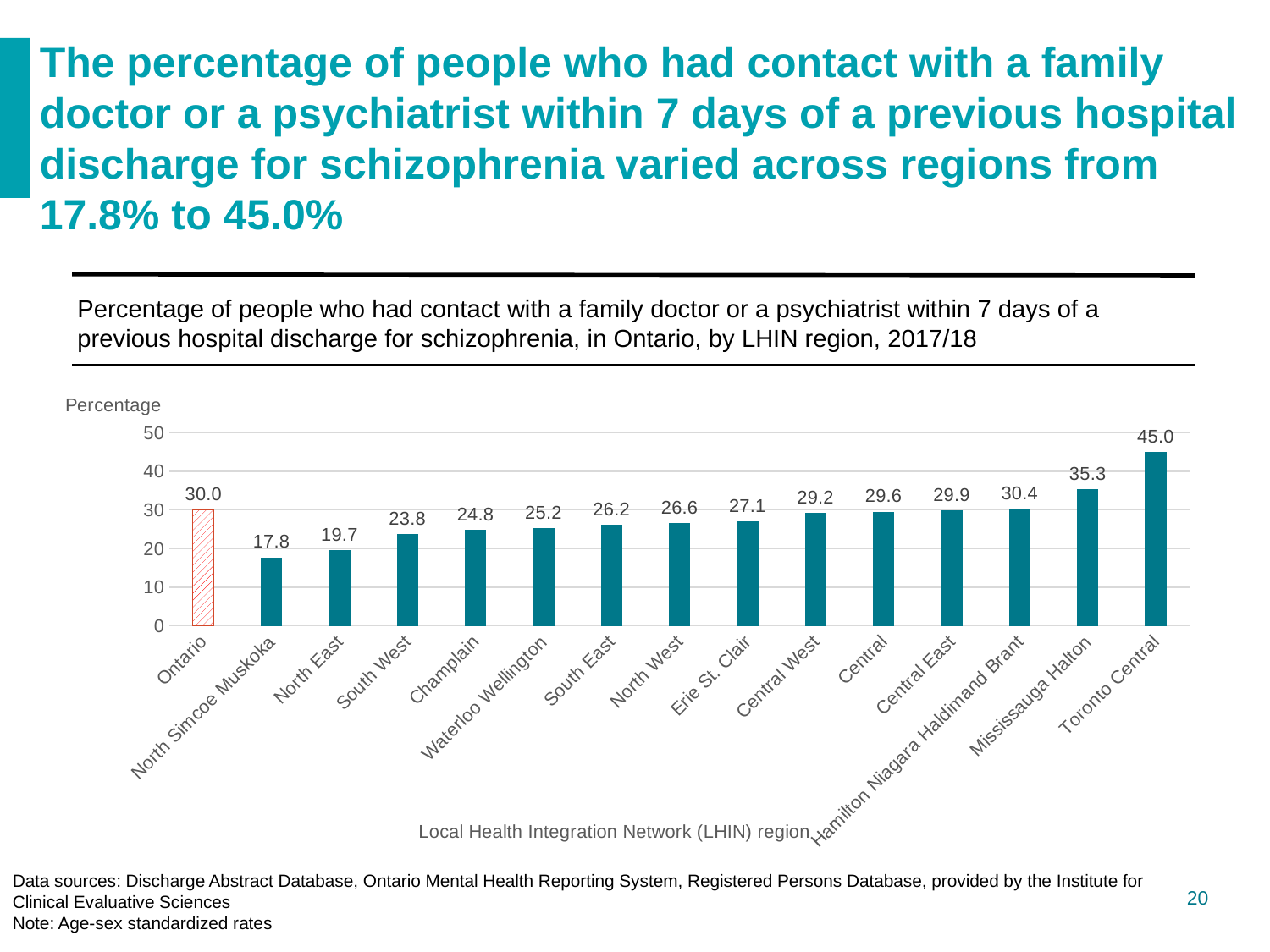
What is the difference between the values for Toronto Central and North Simcoe Muskoka? 27.2 What kind of chart is shown on the slide? bar chart Which LHIN region has the highest value? Toronto Central What is the value for Champlain? 24.8 Excluding the Ontario bar, do the values rise or fall from left to right across the LHIN regions? rise Which LHIN region has the lowest value? North Simcoe Muskoka How many bars are shown in the chart? 15 Is the value for Hamilton Niagara Haldimand Brant greater or less than 40? less What is the value for Toronto Central? 45.0 Which is larger, the value for Mississauga Halton or the value for Central East? Mississauga Halton What is the label of the x axis? Local Health Integration Network (LHIN) region What is the value for Ontario? 30.0